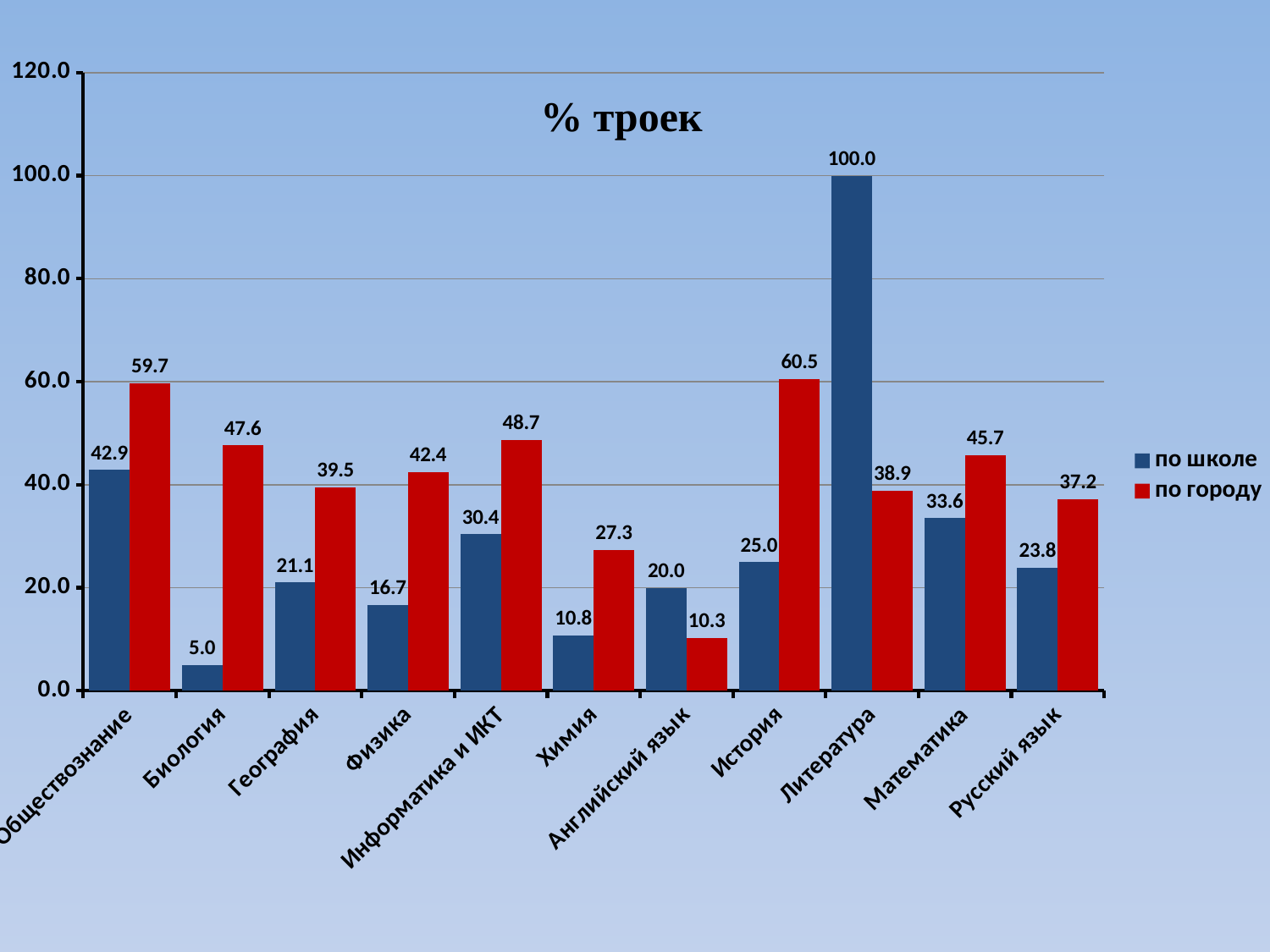
Which is larger for Английский язык: the по школе value or the по городу value? по школе Which category has the lowest value in the по школе series? Биология Which category has the highest value in the по городу series? История What is the value for Литература in the по школе series? 100.0 What is the value for Химия in the по школе series? 10.8 Is the value for Математика in the по городу series greater or less than 40.0? greater What is the difference between the по городу and по школе values for Биология? 42.6 What kind of chart is shown on the slide? bar chart What is the value for Обществознание in the по городу series? 59.7 How many series does the legend list? 2 How many categories are shown on the x axis? 11 What is the title of the chart? % троек